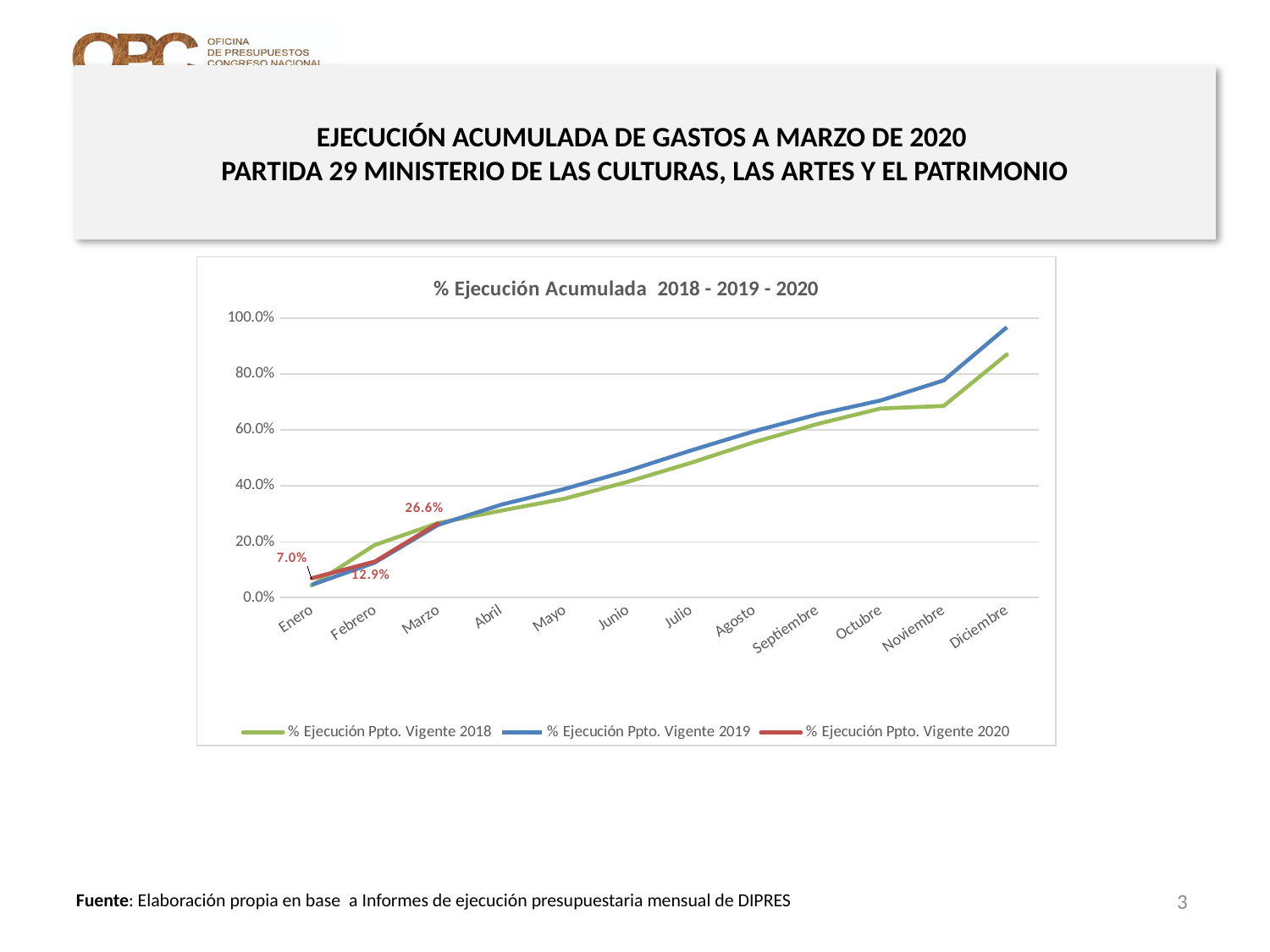
What is the value of % Ejecución Ppto. Vigente 2020 for Febrero? 12.9% What type of chart is shown on the slide? Line chart By how many percentage points did % Ejecución Ppto. Vigente 2020 increase from Febrero to Marzo? 13.7 How many months are shown on the x axis of the chart? 12 What is the value of % Ejecución Ppto. Vigente 2020 for Enero? 7.0% What is the title of the chart? % Ejecución Acumulada 2018 - 2019 - 2020 In Diciembre, which series has the higher value: % Ejecución Ppto. Vigente 2018 or % Ejecución Ppto. Vigente 2019? % Ejecución Ppto. Vigente 2019 Is the value of % Ejecución Ppto. Vigente 2018 for Mayo greater or less than 40.0%? less Do the values of % Ejecución Ppto. Vigente 2019 rise or fall from Enero to Diciembre? Rise How many series does the chart legend list? 3 What is the value of % Ejecución Ppto. Vigente 2020 for Marzo? 26.6% Is the value of % Ejecución Ppto. Vigente 2019 for Diciembre greater or less than 80.0%? greater